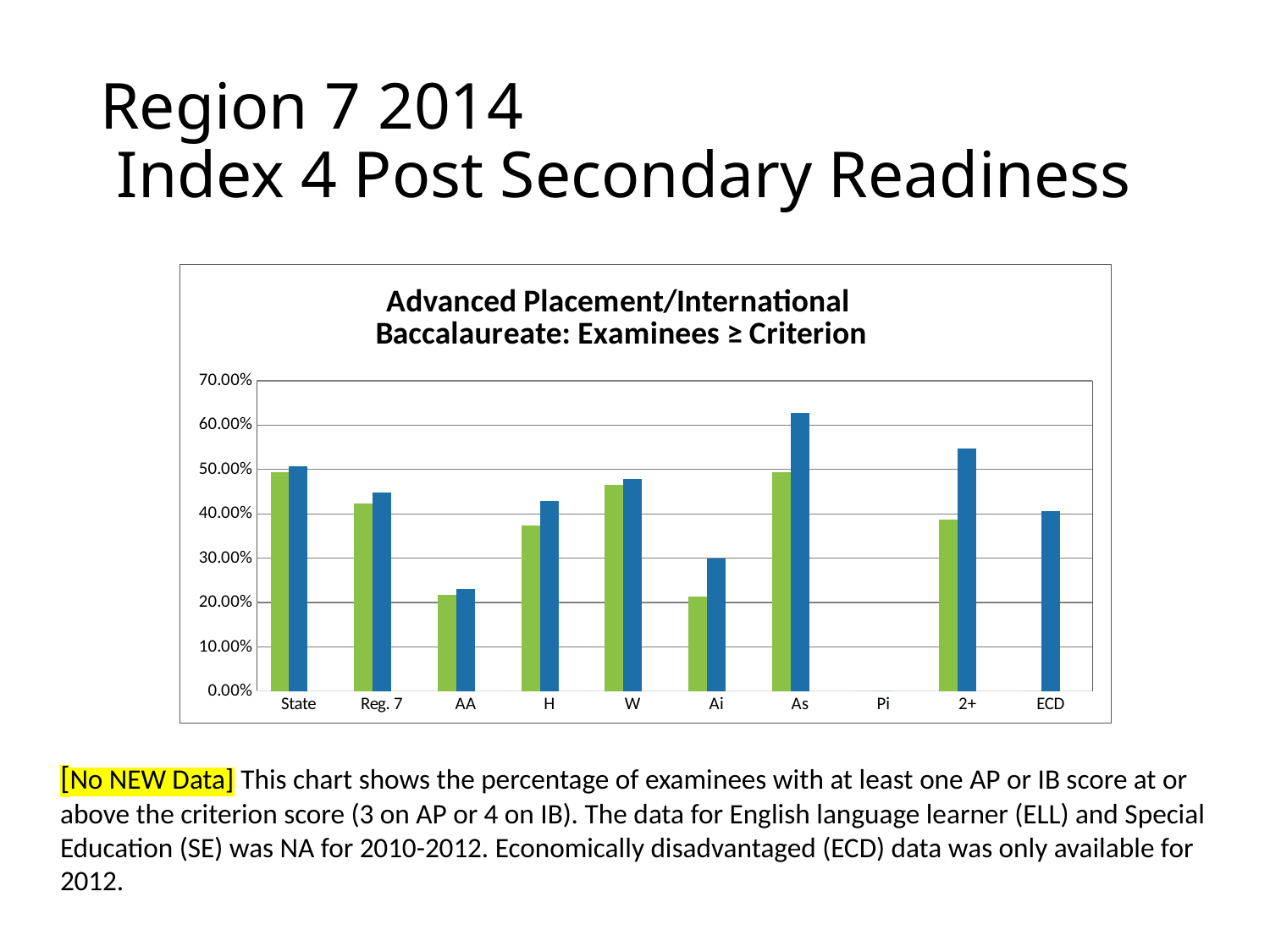
Which is larger, the blue bar for As or the blue bar for State? As What is the title of the chart? Advanced Placement/International Baccalaureate: Examinees ≥ Criterion What kind of chart is shown on the slide? bar chart Is the green bar for H greater or less than 40.00%? less Is the blue bar for 2+ greater or less than 50.00%? greater How many categories are shown on the x axis of the chart? 10 Is the green bar for AA greater or less than 30.00%? less How many bars are plotted for the Pi category? 0 Which is larger, the blue bar for H or the blue bar for Ai? H Which category has the tallest blue bar? As Which category has the shortest blue bar? AA